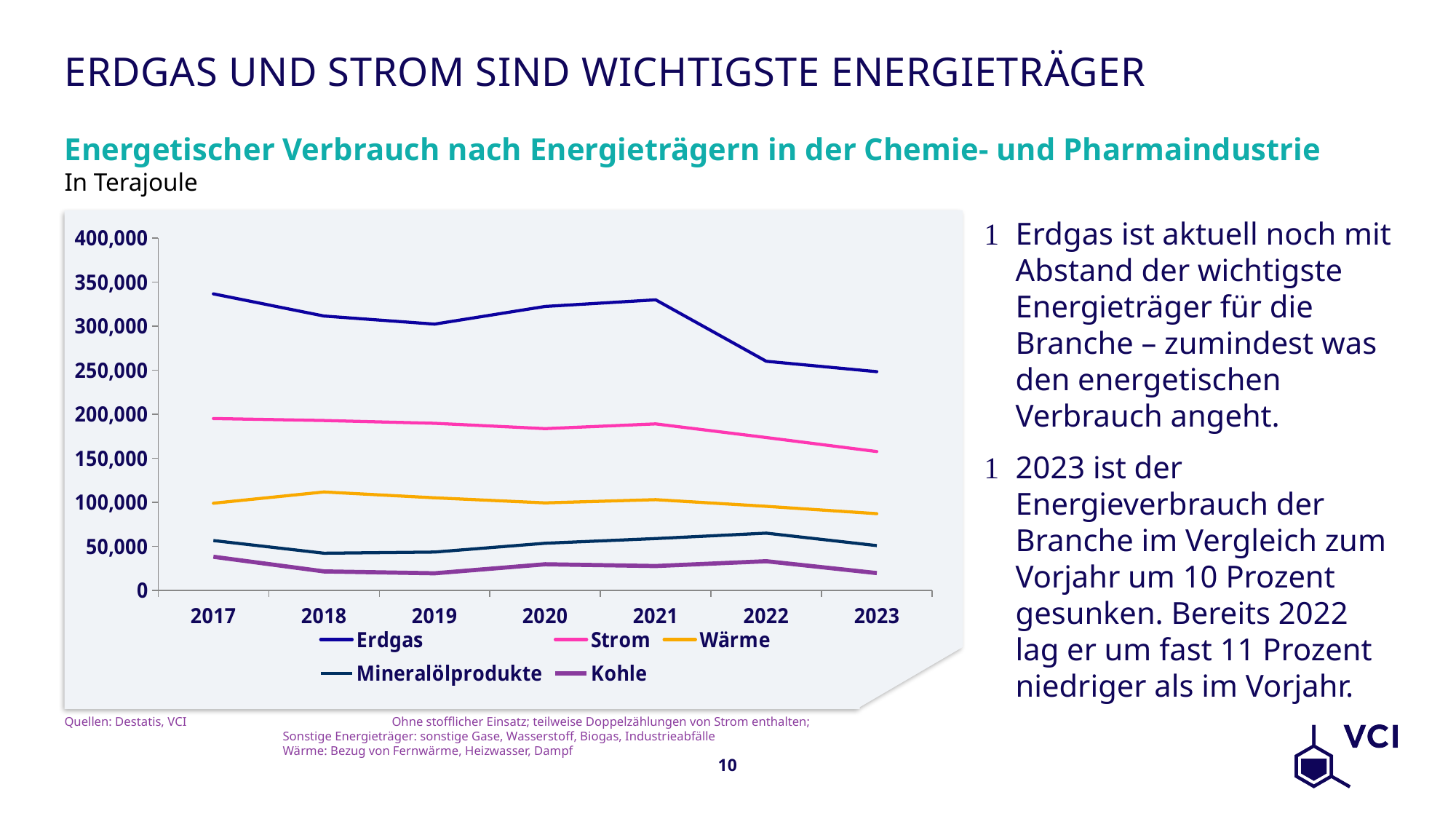
How many series does the chart legend list? 5 Which energy source has the highest consumption in 2023? Erdgas Does the Erdgas line rise or fall from 2021 to 2023? fall Is the value for Erdgas in 2017 greater or less than 300,000? greater In which year is the Wärme value highest? 2018 Which is larger in 2021, Strom or Wärme? Strom What kind of chart is shown on the slide? line chart How many years are plotted along the x axis? 7 In which year is the Erdgas value lowest? 2023 Which energy source has the lowest consumption in 2023? Kohle Is the value for Strom in 2023 greater or less than 150,000? greater Is the value for Wärme in 2023 greater or less than 100,000? less